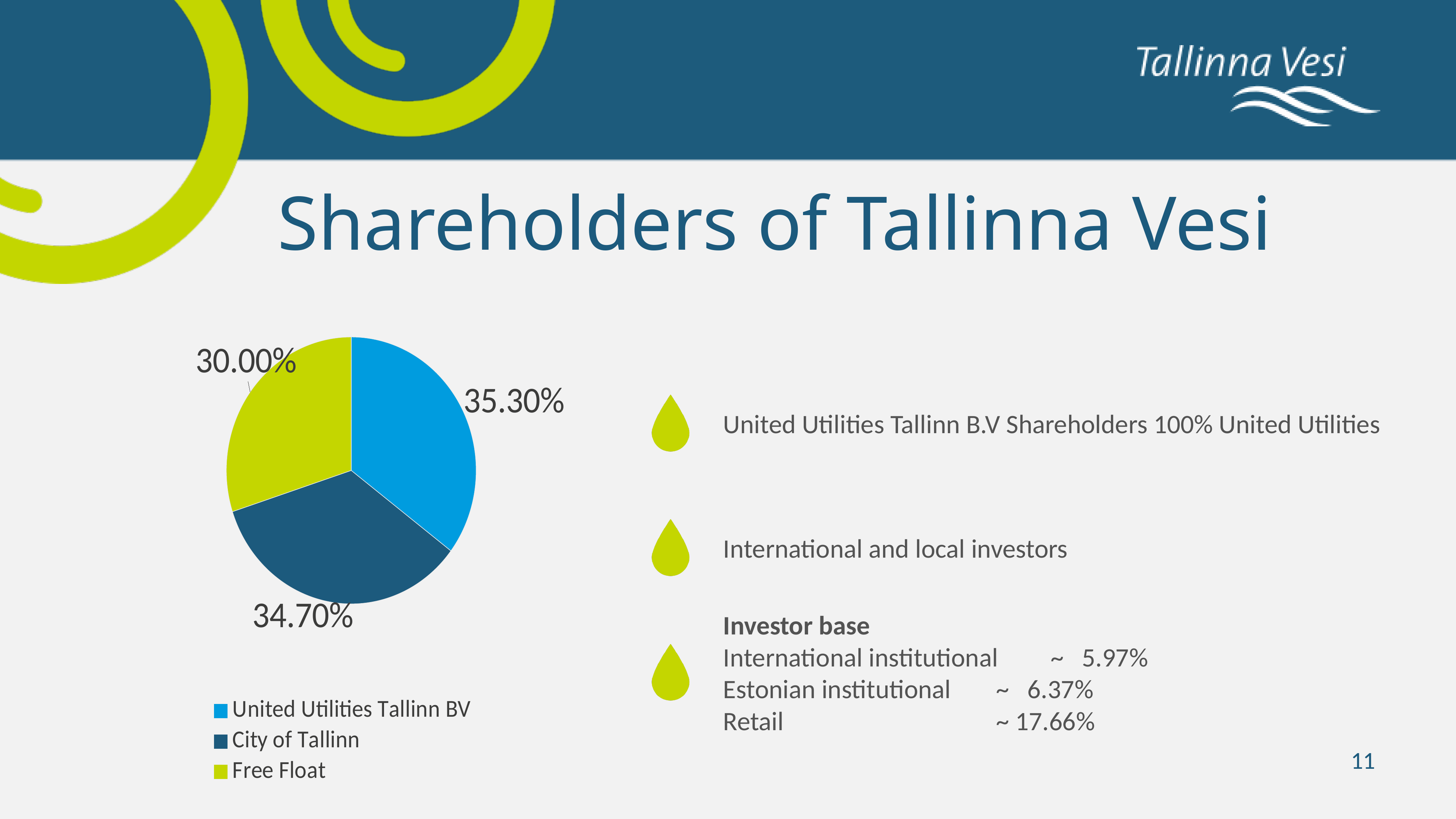
What share of the pie does Free Float hold? 30.00% What share of the pie does United Utilities Tallinn BV hold? 35.30% Which shareholder has the smallest slice of the pie? Free Float Which is larger, the City of Tallinn share or the Free Float share? City of Tallinn Which shareholder has the largest slice of the pie? United Utilities Tallinn BV What is the difference between the City of Tallinn share and the Free Float share? 4.70% What kind of chart is shown on the slide? pie chart What share of the pie does City of Tallinn hold? 34.70% Which colour represents Free Float in the pie chart? green How many slices does the pie chart have? 3 What is the difference between the United Utilities Tallinn BV share and the City of Tallinn share? 0.60% How many entries does the legend list? 3